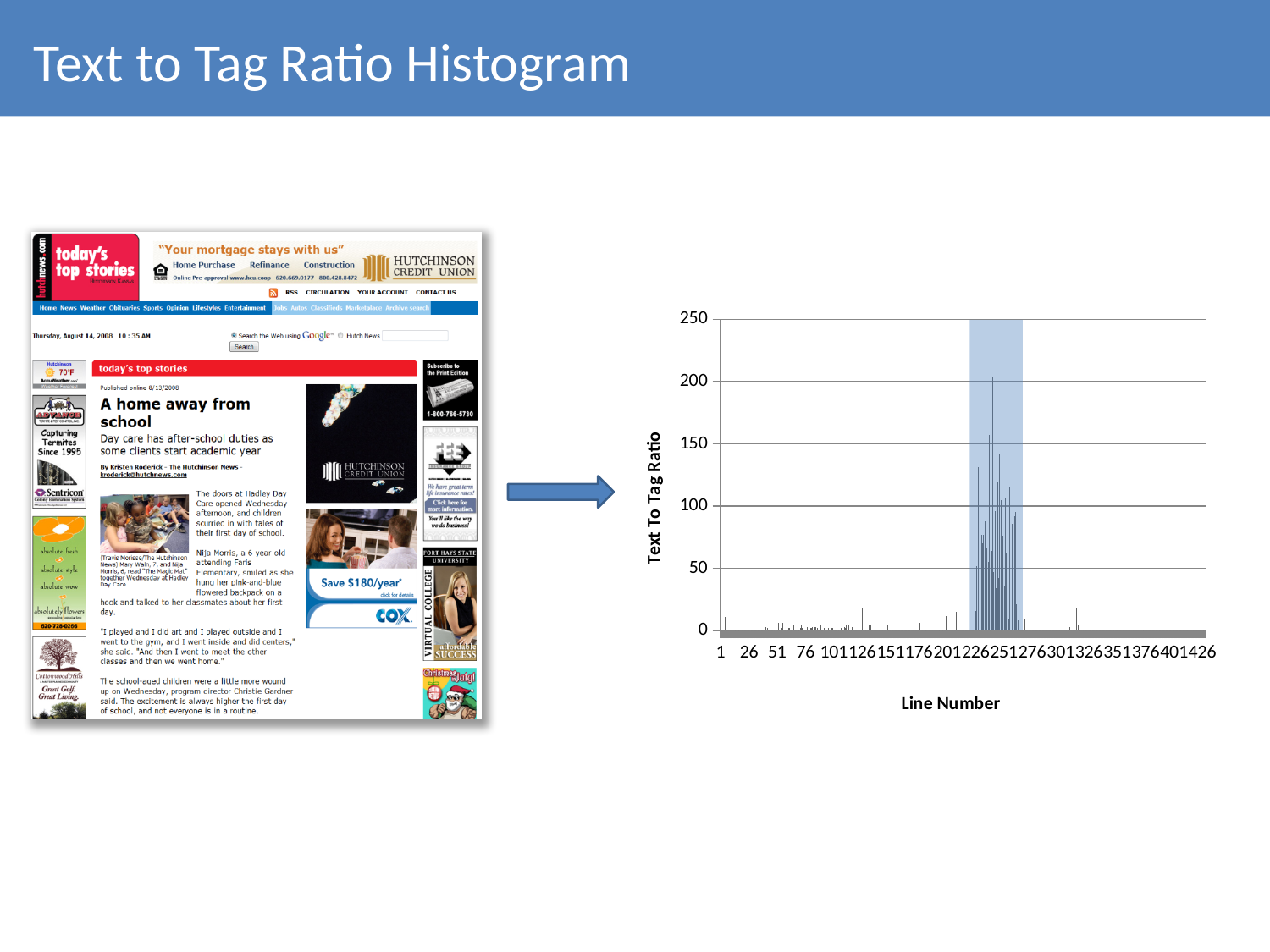
What is the label of the vertical axis of the chart? Text To Tag Ratio What is the label of the horizontal axis of the chart? Line Number Is the value for line number 1 greater or less than 50? less Is the tallest bar in the chart greater or less than 250? less What is the title of the slide containing the chart? Text to Tag Ratio Histogram What is the last tick label shown on the horizontal axis of the chart? 426 What is the first tick label shown on the horizontal axis of the chart? 1 What is the highest tick value shown on the vertical axis of the chart? 250 Is the tallest bar in the chart greater or less than 150? greater What kind of chart is shown on the right side of the slide? bar chart